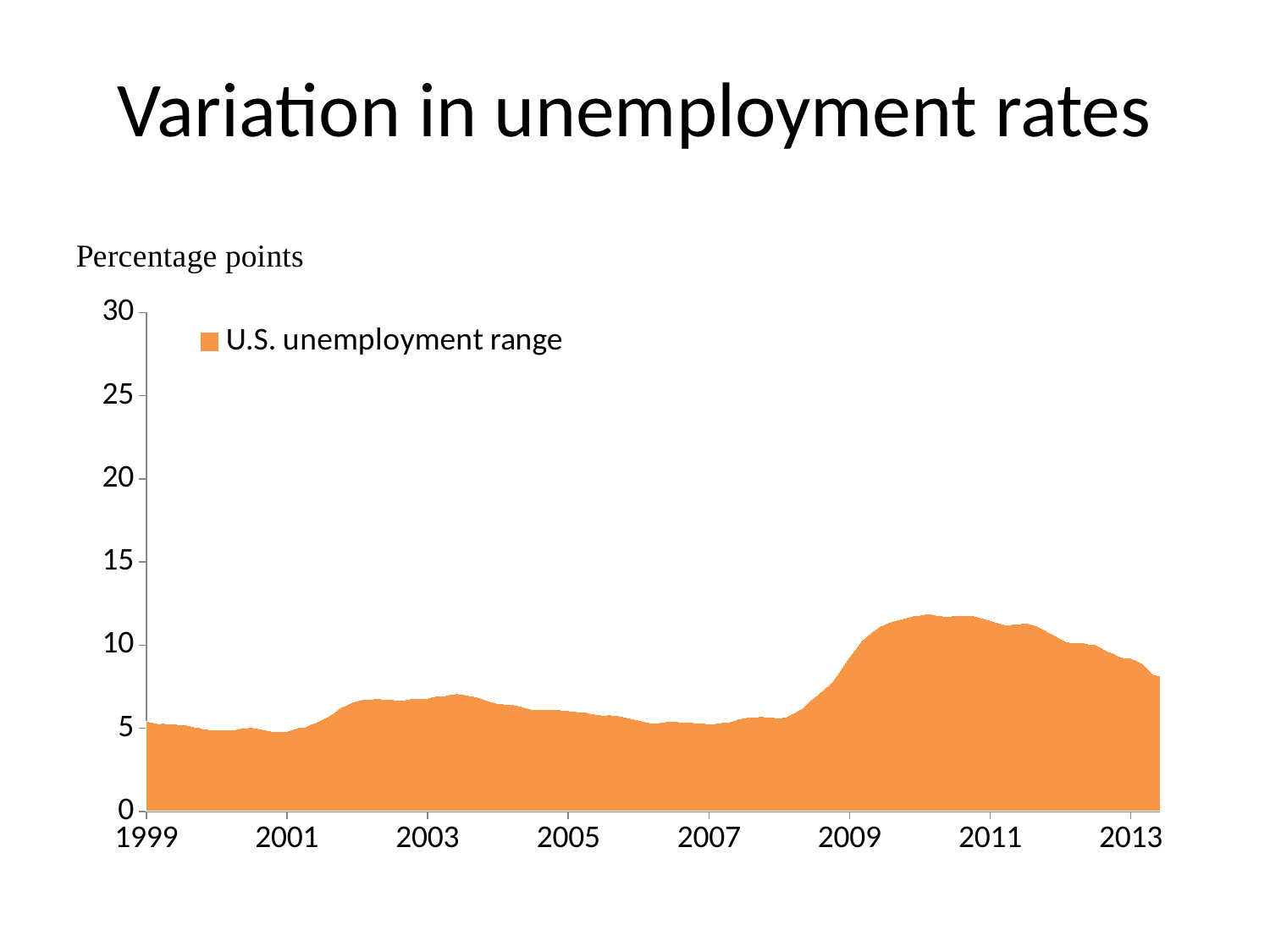
Around which year does the U.S. unemployment range reach its highest value? 2010 Is the value for 2013 greater or less than 10? less What is the name of the series shown in the legend? U.S. unemployment range Do the values rise or fall between 2011 and 2013? fall How many series does the legend list? 1 Is the value for 2003 greater or less than 10? less Is the value for 2010 greater or less than 10? greater What kind of chart is shown on the slide? area chart What unit label is shown above the chart's y axis? Percentage points Do the values rise or fall between 2007 and 2010? rise